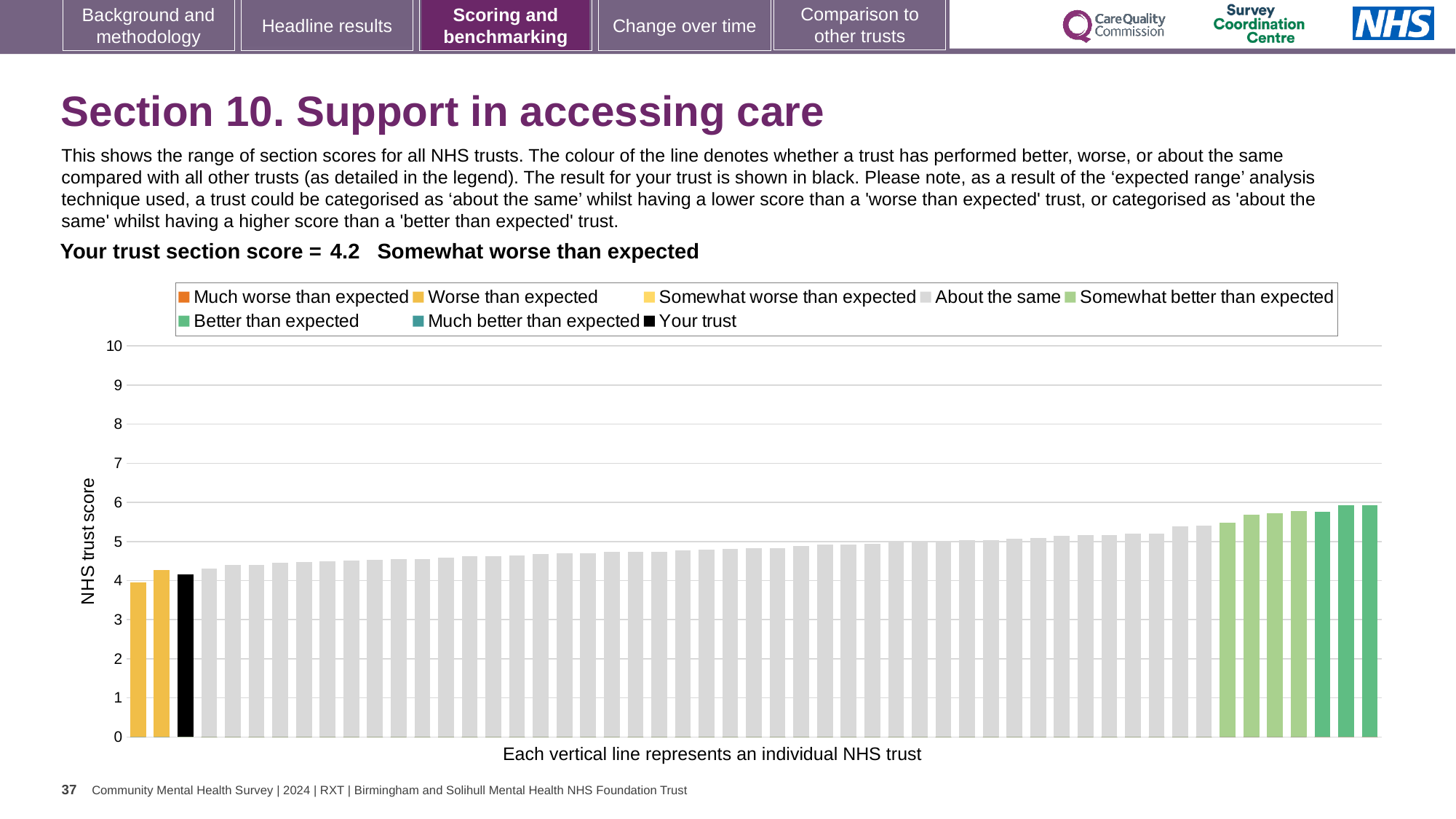
What is the section score for your trust shown on the slide? 4.2 Is the value of the black bar (your trust) greater or less than 5? less What is the label on the vertical axis of the chart? NHS trust score Do the bar values rise or fall from left to right along the x axis? rise How many bars are coloured black on the chart? 1 Is the value of the tallest bar greater or less than 5? greater How is your trust's section score categorised on the slide? Somewhat worse than expected What is the highest value shown on the vertical axis? 10 Is the value of the shortest bar greater or less than 5? less What kind of chart is shown on the slide? bar chart How many entries does the chart legend list? 8